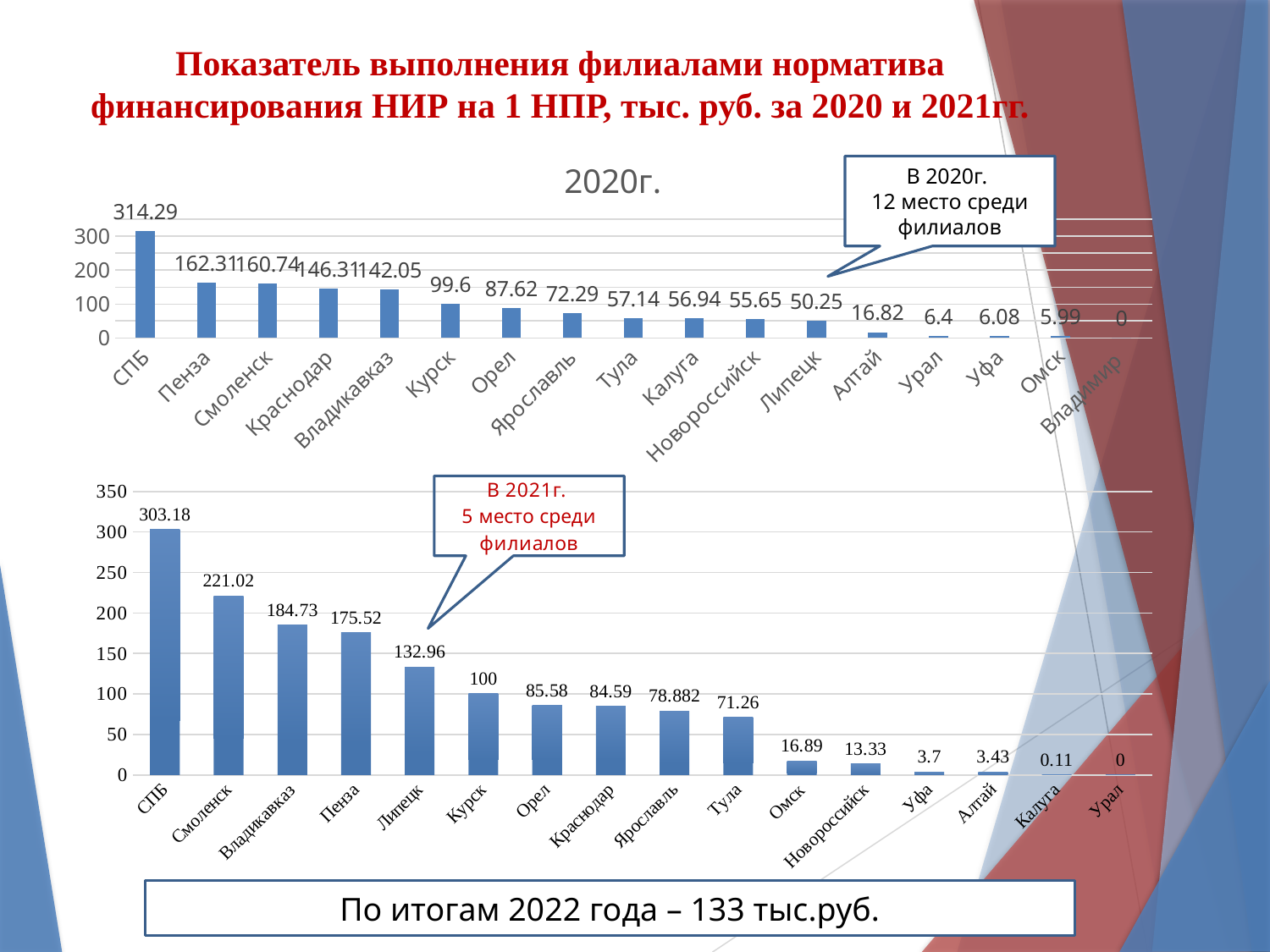
How many categories are shown in the top chart titled "2020г."? 17 In the bottom chart, what is the difference between the values for СПБ and Смоленск? 82.16 In the top chart titled "2020г.", which category has the highest value? СПБ In the bottom chart, is the value for Владикавказ greater or less than 150? greater In the bottom chart, what is the value for Липецк? 132.96 In the top chart titled "2020г.", which is larger, the value for Курск or the value for Орел? Курск How many categories are shown in the bottom chart? 16 In the top chart titled "2020г.", what is the value for Пенза? 162.31 In the bottom chart, which category has the lowest value? Урал In the top chart titled "2020г.", what is the value for Липецк? 50.25 In the bottom chart, what is the value for Ярославль? 78.882 What kind of chart is the bottom chart? bar chart